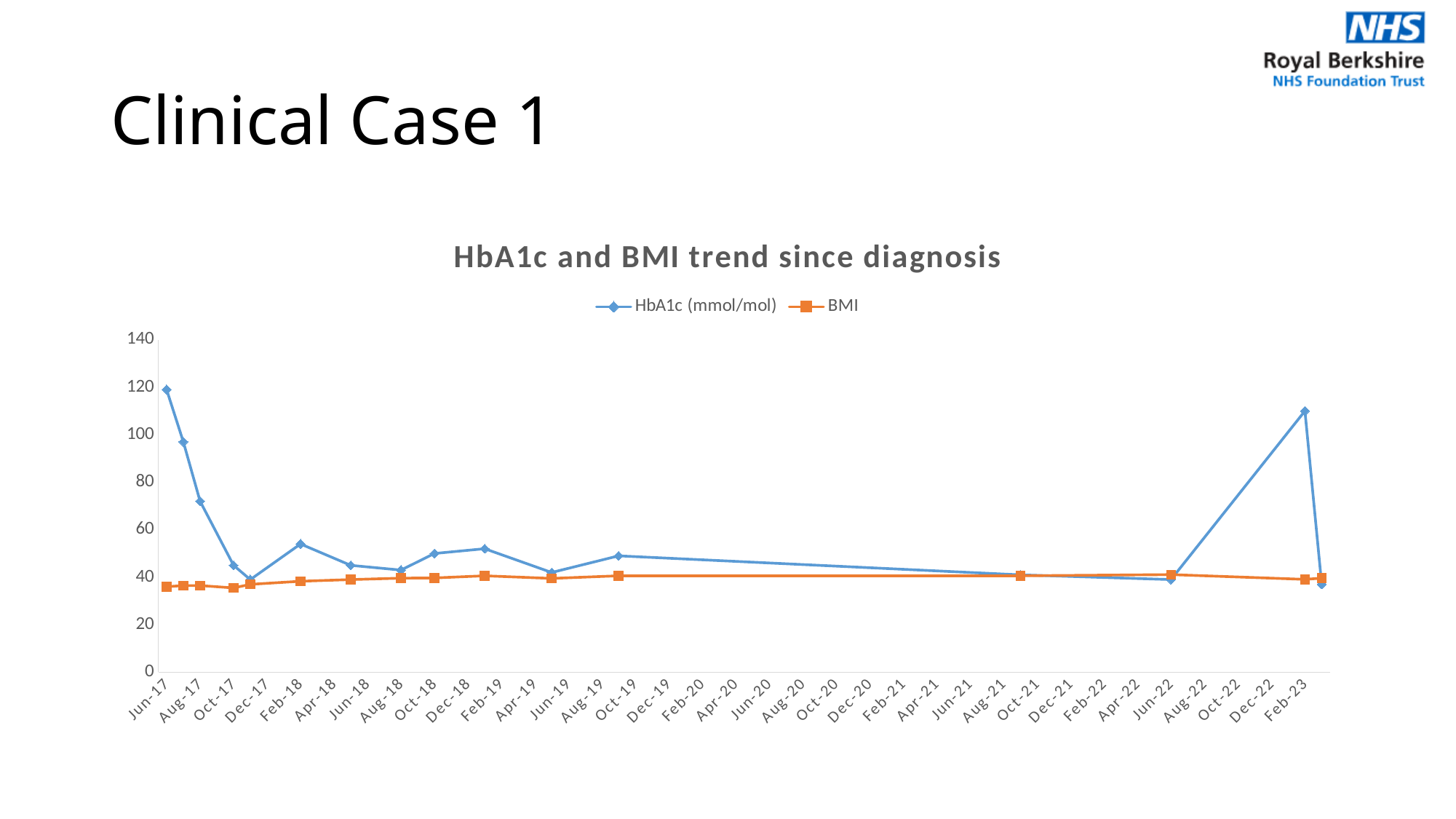
Does the HbA1c (mmol/mol) line rise or fall between Jun-17 and Oct-17? fall Which two series are listed in the legend? HbA1c (mmol/mol) and BMI What kind of chart is shown on the slide? line chart At Jun-17, which series has the larger value, HbA1c (mmol/mol) or BMI? HbA1c (mmol/mol) How many series does the legend list? 2 Is the BMI value at Jun-17 greater or less than 40? less Is the HbA1c (mmol/mol) value at Jun-17 greater or less than 100? greater What is the title of the chart? HbA1c and BMI trend since diagnosis Is the HbA1c (mmol/mol) value at Aug-17 greater or less than 80? less At which date does the HbA1c (mmol/mol) series reach its highest value? Jun-17